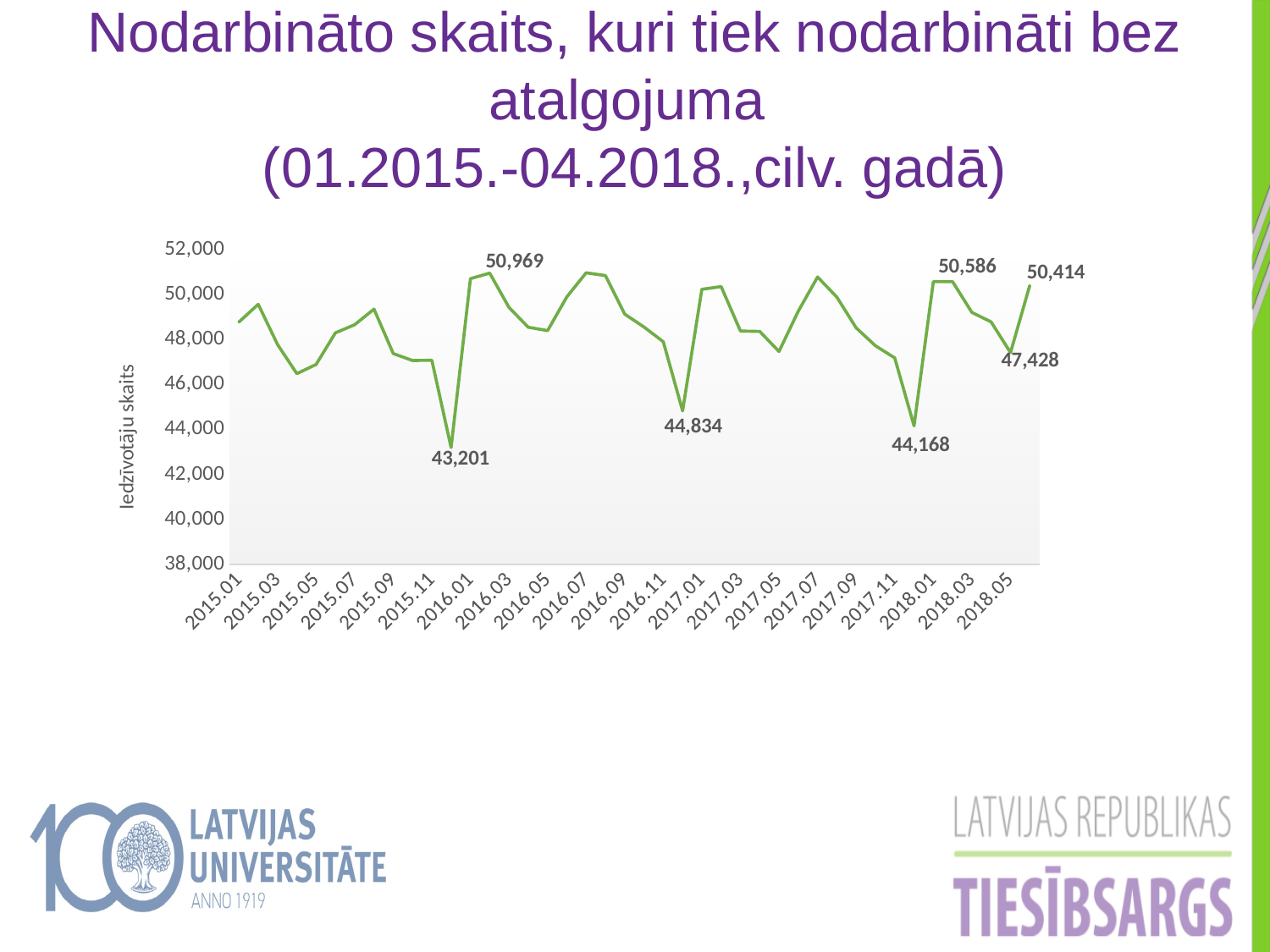
What is the labeled value of the dip just before 2018.01? 44,168 What kind of chart is shown on the slide? line chart What is the lowest labeled value on the line? 43,201 What is the title of the vertical axis? Iedzīvotāju skaits How many data points on the line have printed value labels? 7 Is the value at 2015.01 greater or less than 48,000? greater What is the difference between the highest labeled value (50,969) and the lowest labeled value (43,201)? 7,768 What is the labeled value at 2018.01? 50,586 What is the highest labeled value on the line? 50,969 Which is larger, the labeled value 50,969 or the labeled value 50,586? 50,969 What is the difference between the labeled values 50,586 and 44,168? 6,418 What is the value of the last data point on the line? 50,414